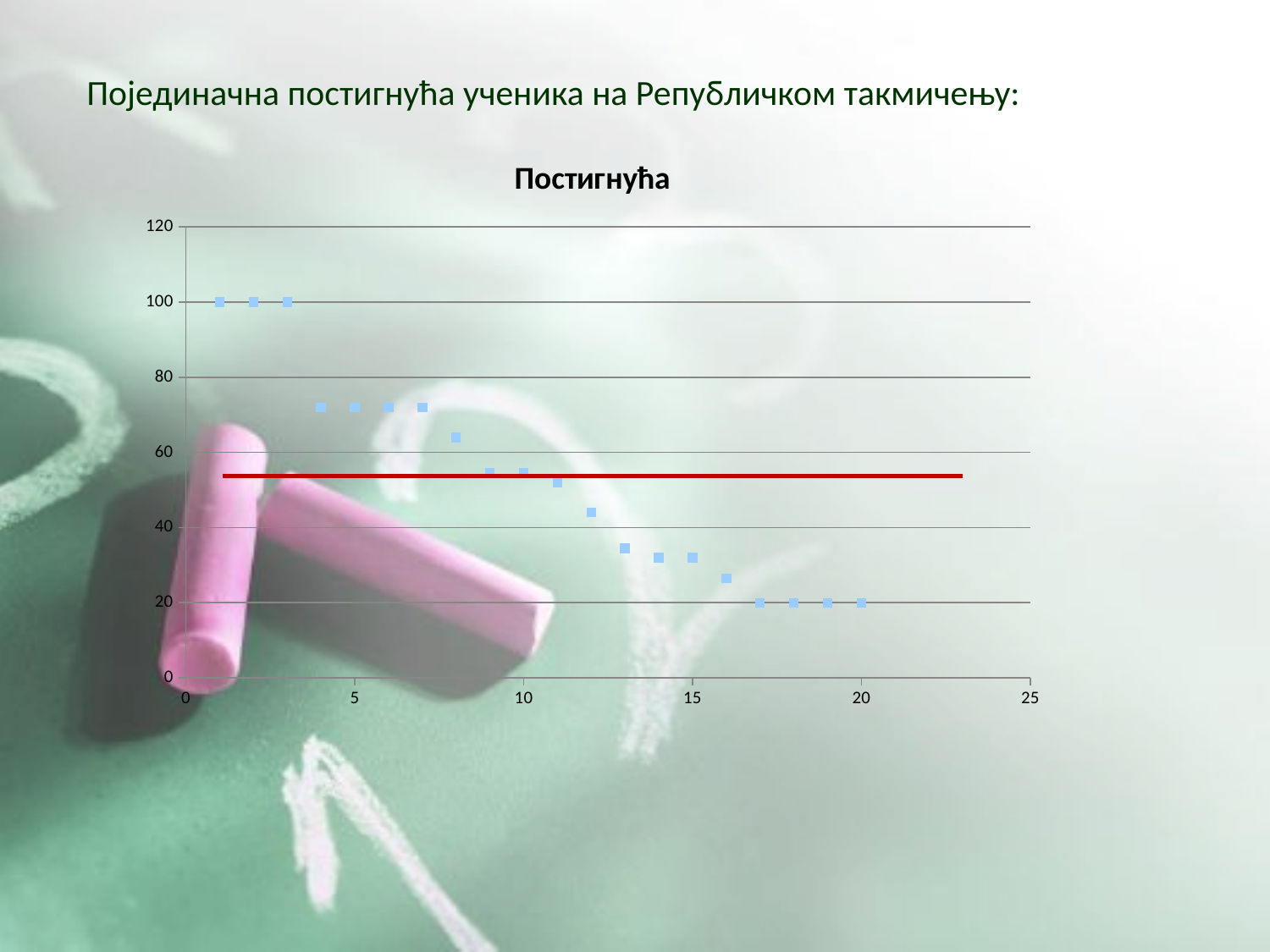
Is the red horizontal line drawn above or below the 40 gridline? above Is the value of the point at x = 13 greater or less than 40? less Is the value of the point at x = 5 greater or less than 60? greater Do the plotted values rise or fall as the x value increases from 1 to 20? fall Which point has the larger value, the one at x = 4 or the one at x = 12? x = 4 Is the value of the point at x = 16 greater or less than 20? greater What is the value of the point at x = 20? 20 How many data points are plotted in the chart? 20 What is the title of the chart? Постигнућа What kind of chart is shown on the slide? scatter chart What is the value of the point at x = 1? 100